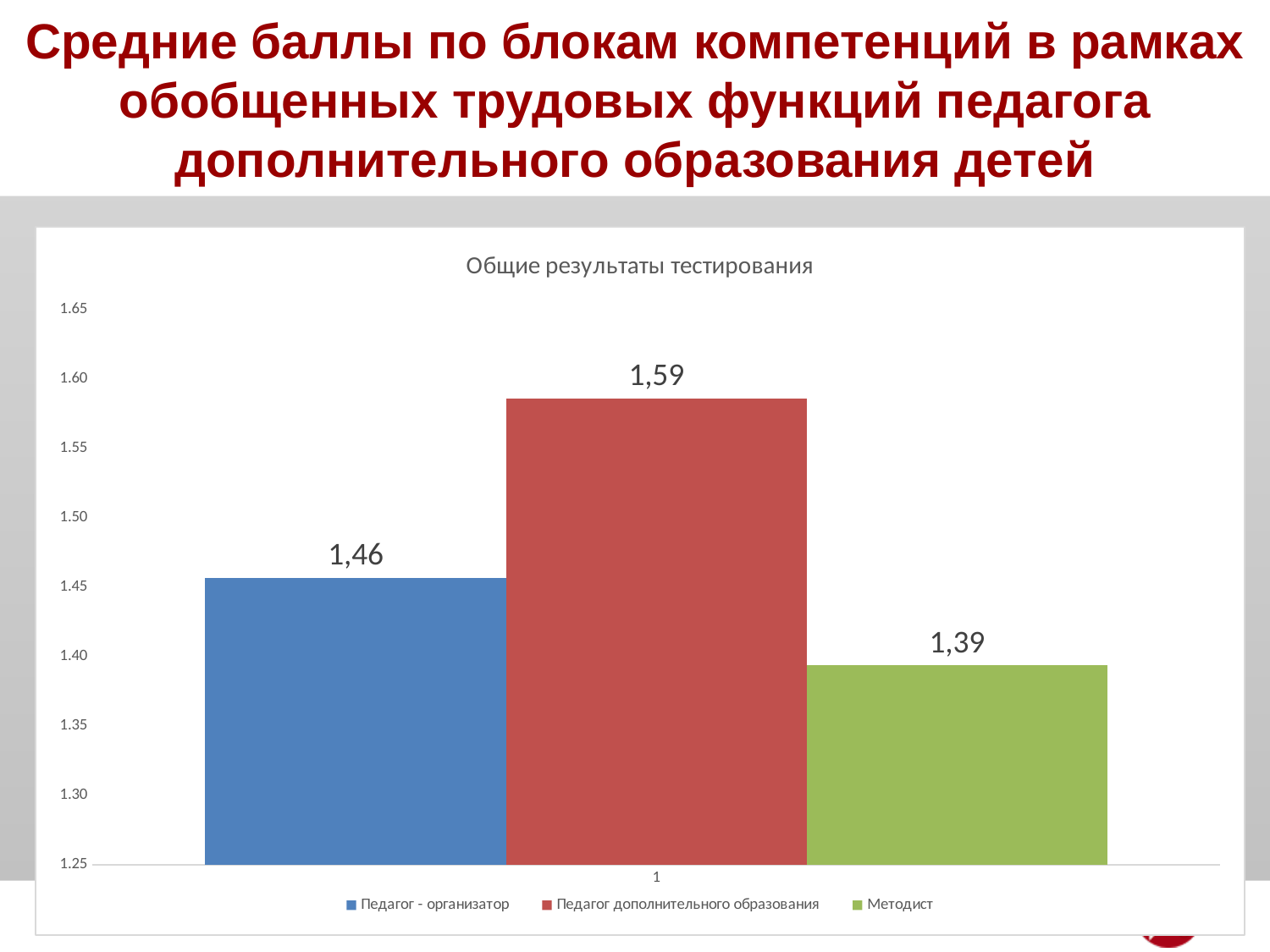
What is the difference between the values for Педагог дополнительного образования and Педагог - организатор? 0,13 Is the value for Методист greater or less than 1.40? less What kind of chart is shown on the slide? bar chart Which series has the lowest value? Методист What is the difference between the values for Педагог дополнительного образования and Методист? 0,20 What is the value for Методист? 1,39 What is the value for Педагог - организатор? 1,46 How many series does the legend list? 3 Which series has the highest value? Педагог дополнительного образования What is the value for Педагог дополнительного образования? 1,59 What is the title of the chart? Общие результаты тестирования Which is larger, the value for Педагог - организатор or the value for Методист? Педагог - организатор